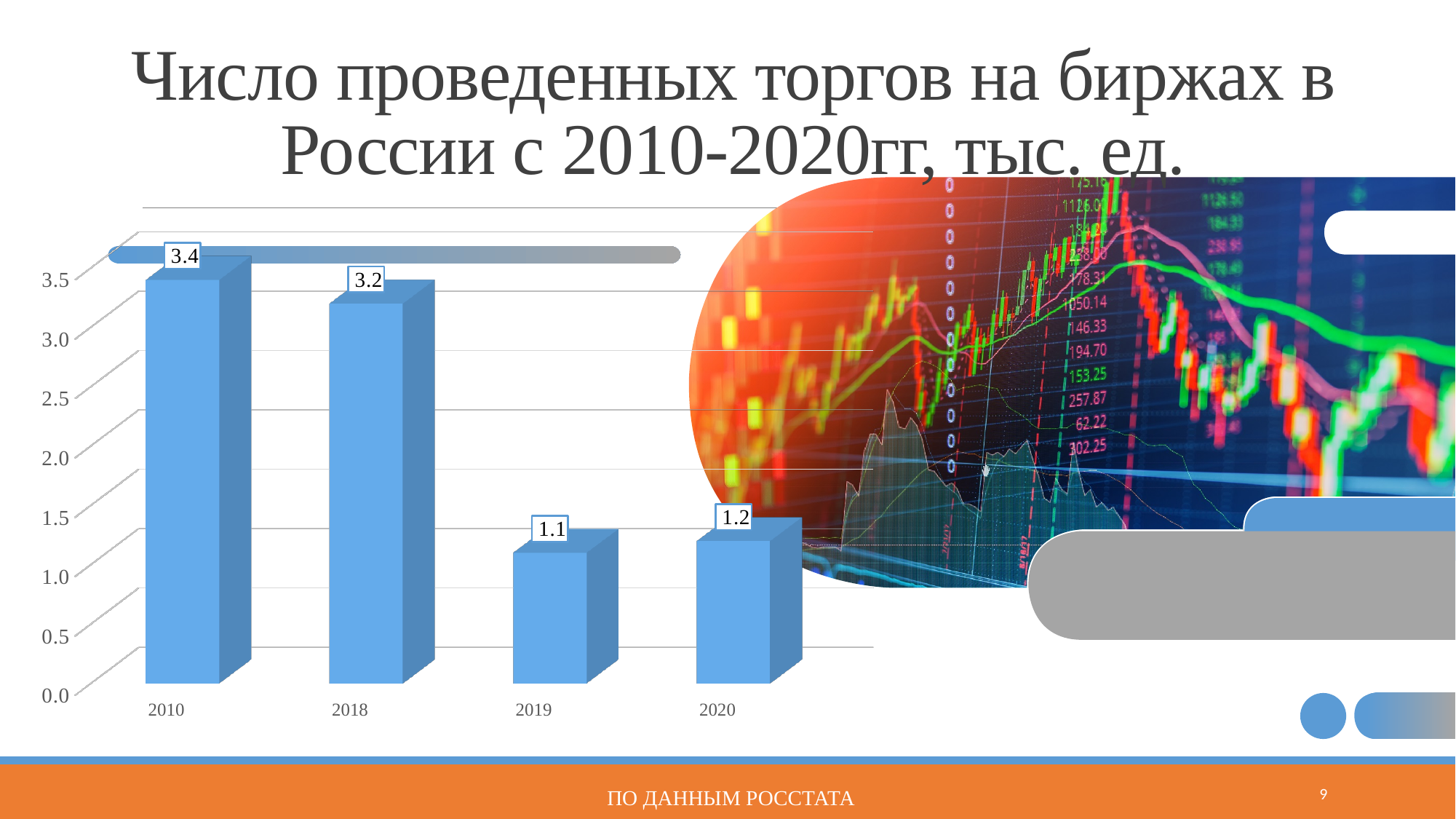
Do the values generally rise or fall from 2010 to 2020? fall What is the difference between the values for 2010 and 2019? 2.3 What is the value for 2010? 3.4 What kind of chart is shown on the slide? bar chart Which year has the highest value? 2010 Which year has the lowest value? 2019 What is the value for 2020? 1.2 What is the value for 2019? 1.1 Which is larger, the value for 2010 or the value for 2020? 2010 What is the value for 2018? 3.2 How many years are shown on the x axis? 4 What is the difference between the values for 2018 and 2020? 2.0